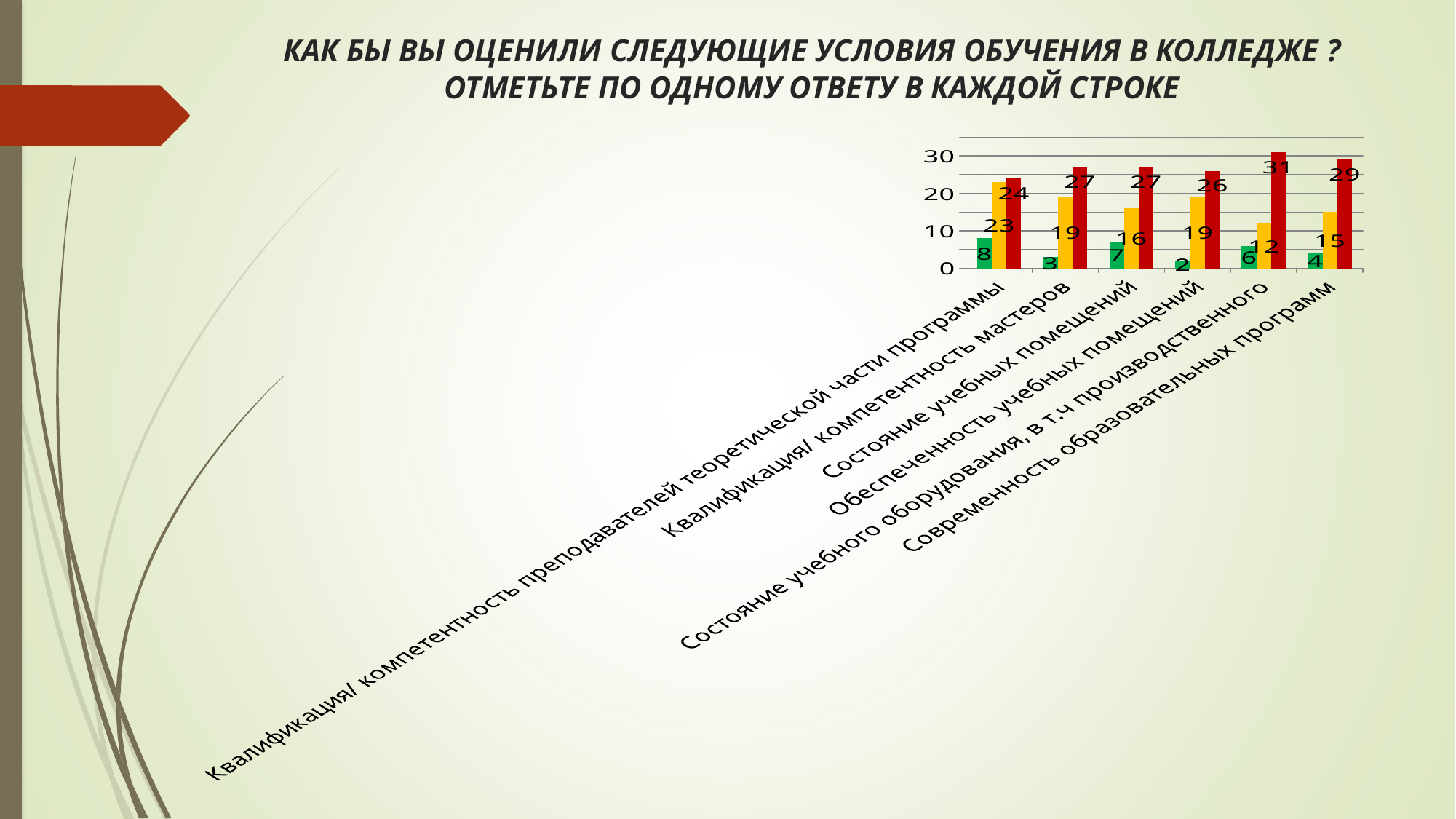
Is the value of the red bar for "Современность образовательных программ" greater or less than 20? greater What is the difference between the red bar and the yellow bar for "Состояние учебного оборудования, в т.ч производственного"? 19 Which is larger for "Квалификация/ компетентность мастеров": the yellow bar or the red bar? the red bar How many categories are shown on the x axis of the chart? 6 What is the value of the green bar for "Обеспеченность учебных помещений"? 2 What is the value of the yellow bar for "Современность образовательных программ"? 15 What is the total of the three bars for "Состояние учебных помещений"? 50 What is the value of the yellow bar for "Квалификация/ компетентность преподавателей теоретической части программы"? 23 Which category has the lowest green bar? Обеспеченность учебных помещений What kind of chart is shown on the slide? bar chart Which category has the highest red bar? Состояние учебного оборудования, в т.ч производственного What is the value of the red bar for "Состояние учебного оборудования, в т.ч производственного"? 31